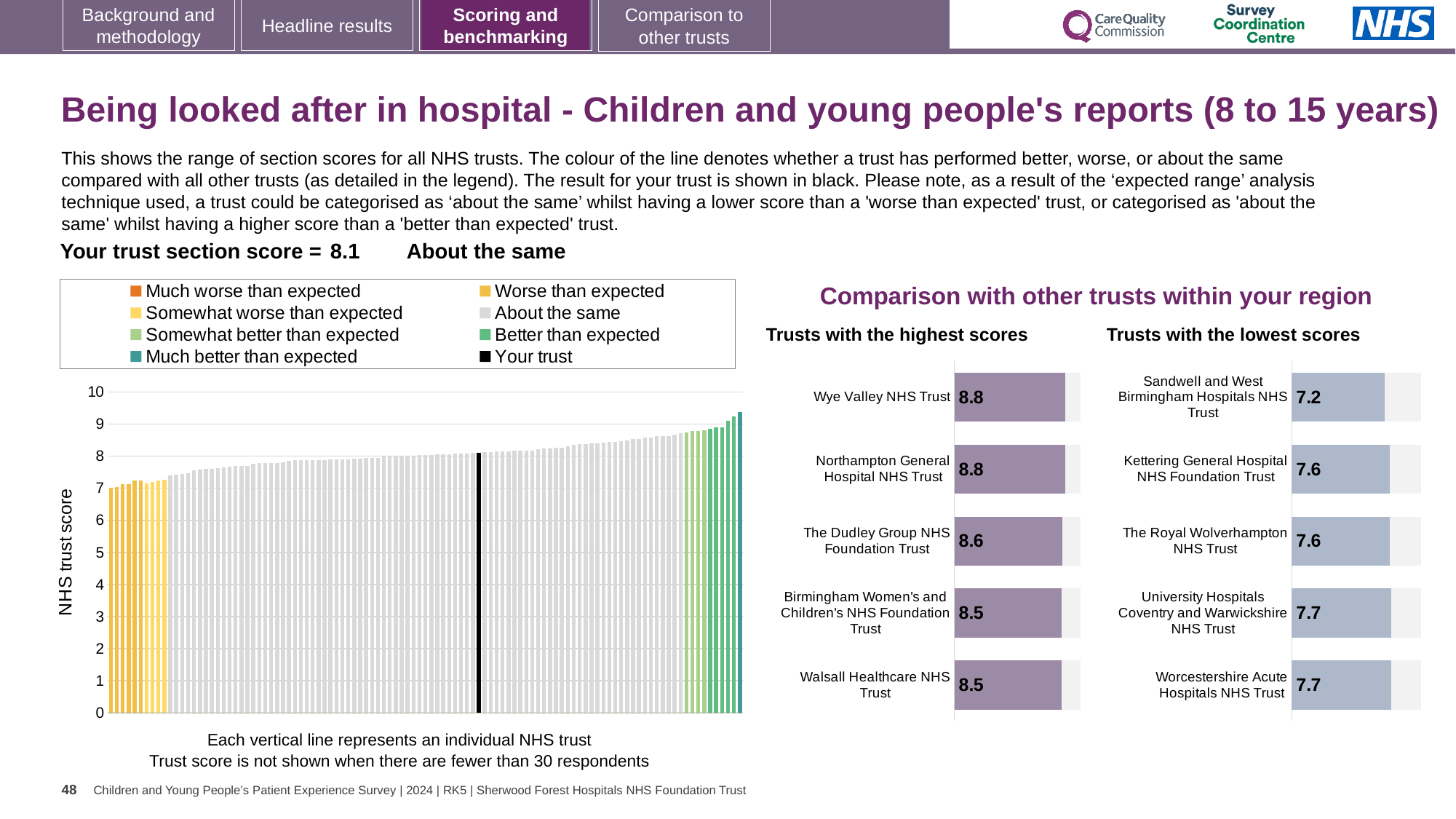
In the 'Trusts with the lowest scores' chart, which trust has the lowest score? Sandwell and West Birmingham Hospitals NHS Trust How many trusts are shown in the 'Trusts with the lowest scores' chart? 5 In the 'Trusts with the lowest scores' chart, what is the score for Kettering General Hospital NHS Foundation Trust? 7.6 In the left chart, do the trust scores rise or fall from left to right along the x axis? rise What is the difference between Wye Valley NHS Trust's score in the 'Trusts with the highest scores' chart and Sandwell and West Birmingham Hospitals NHS Trust's score in the 'Trusts with the lowest scores' chart? 1.6 In the 'Trusts with the highest scores' chart, what is the score for Walsall Healthcare NHS Trust? 8.5 How many entries does the legend above the left chart list? 8 Which has the higher score: The Dudley Group NHS Foundation Trust in the highest scores chart or The Royal Wolverhampton NHS Trust in the lowest scores chart? The Dudley Group NHS Foundation Trust In the left chart, what colour represents 'Your trust' according to the legend? black What kind of chart is the large chart on the left showing NHS trust scores? bar chart In the 'Trusts with the highest scores' chart, what is the score for The Dudley Group NHS Foundation Trust? 8.6 In the left chart, what is the section score for your trust (the black bar)? 8.1